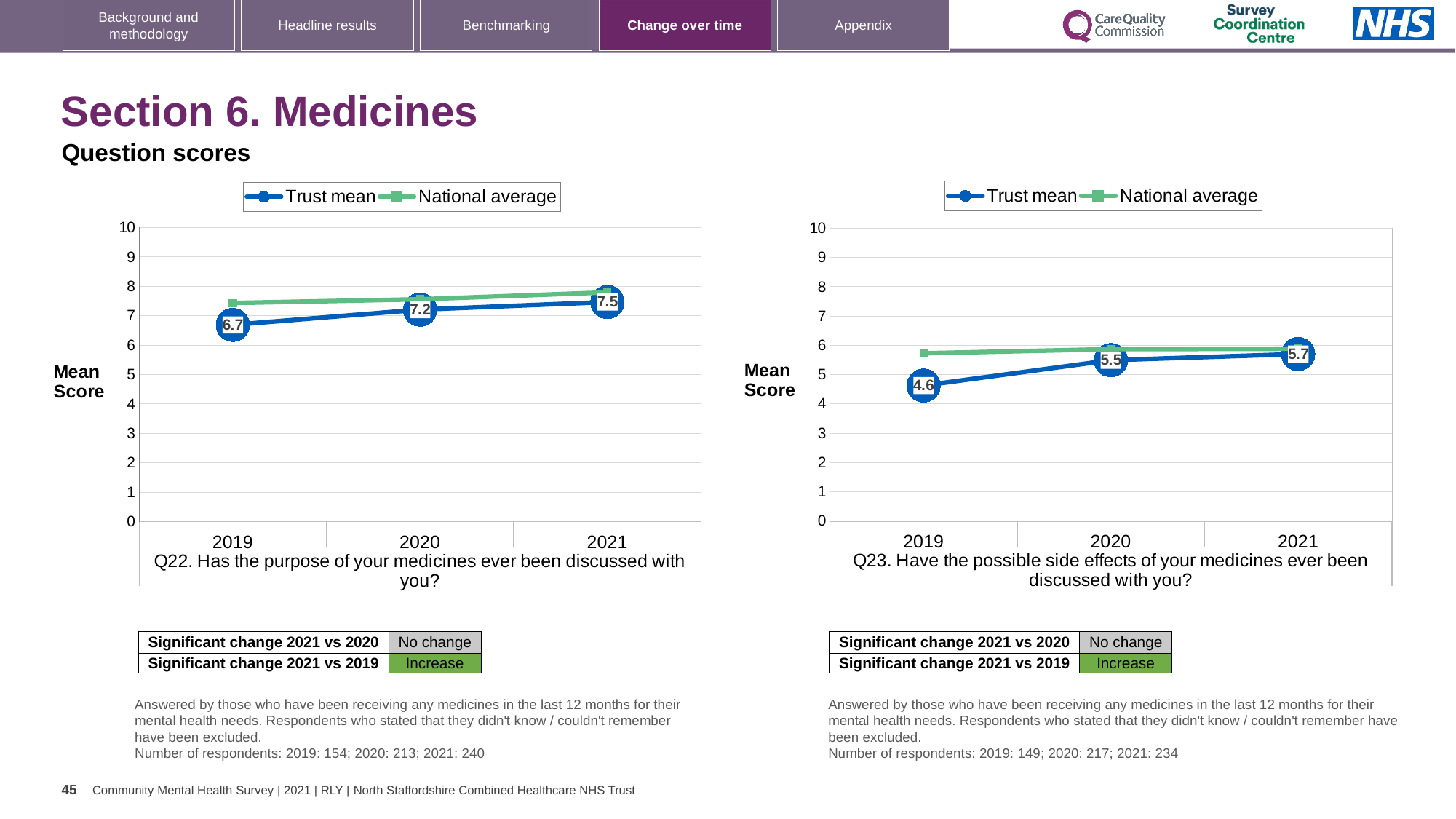
In the Q22 chart (left), which year has the highest Trust mean score? 2021 In the Q23 chart (right), does the Trust mean rise or fall from 2019 to 2021? rise How many series does the legend of the Q22 chart (left) list? 2 In the Q23 chart (right), in 2019 which is higher, the Trust mean or the National average? National average In the Q22 chart (left), what is the Trust mean score for 2019? 6.7 In the Q22 chart (left), by how much did the Trust mean increase from 2019 to 2021? 0.8 In the Q23 chart (right), what is the Trust mean score for 2019? 4.6 In the Q22 chart (left), is the National average for 2021 greater or less than 7? greater In the Q22 chart (left), what is the Trust mean score for 2021? 7.5 In the Q23 chart (right), what is the difference between the Trust mean in 2021 and in 2019? 1.1 In the Q23 chart (right), which year has the lowest Trust mean score? 2019 In the Q23 chart (right), what is the Trust mean score for 2020? 5.5